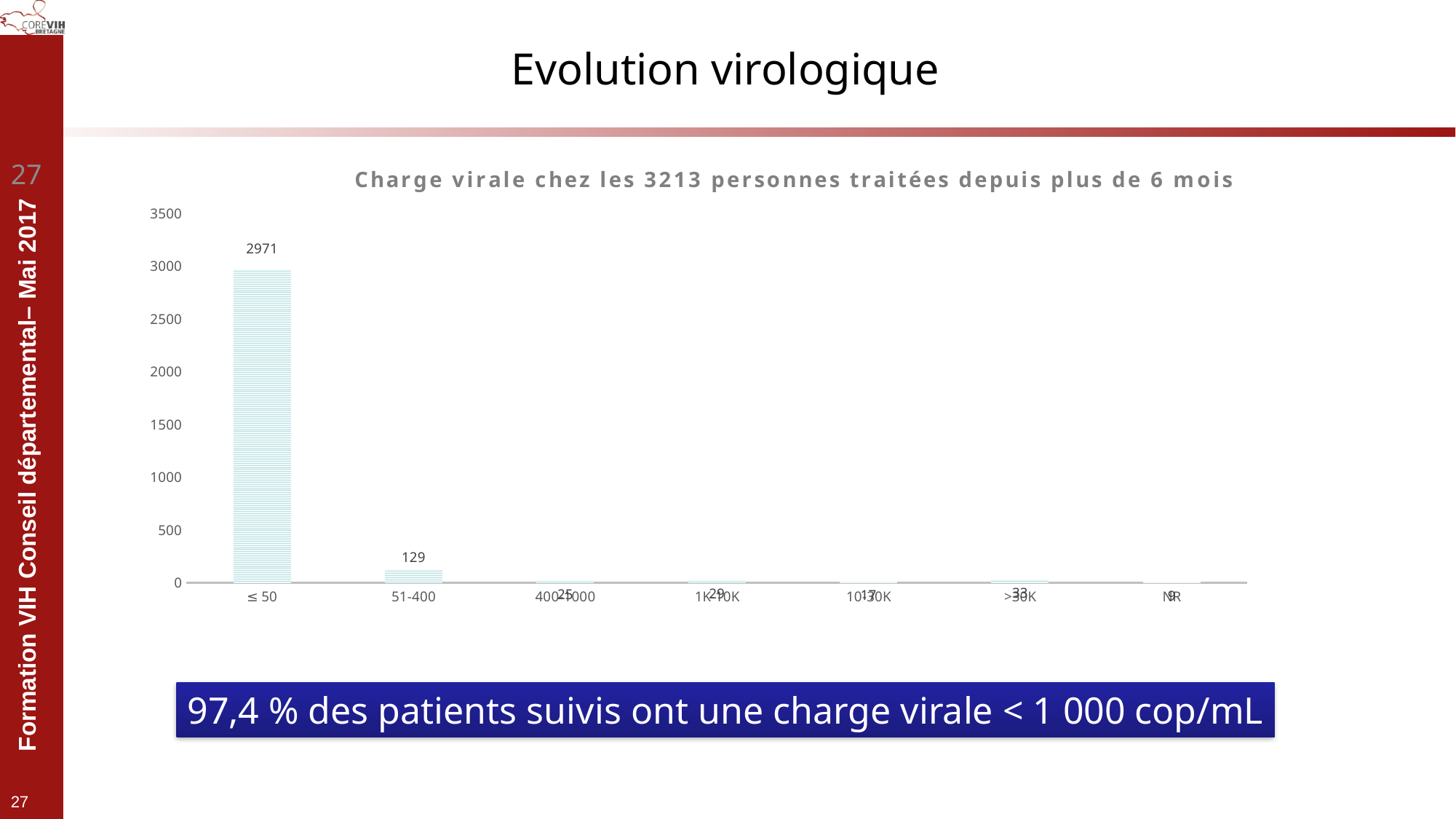
What kind of chart is shown on the slide? bar chart What is the difference between the values for ≤ 50 and 51-400? 2842 Is the value for 1K-10K greater or less than 500? less Which is larger, the value for ≤ 50 or the value for 51-400? ≤ 50 What is the title of the chart? Charge virale chez les 3213 personnes traitées depuis plus de 6 mois Is the value for ≤ 50 greater or less than 2500? greater Is the value for 51-400 greater or less than 500? less Which category has the highest value? ≤ 50 What is the value for the 51-400 category? 129 What is the value for the ≤ 50 category? 2971 How many categories are shown on the x axis? 7 What is the highest value shown on the y axis? 3500